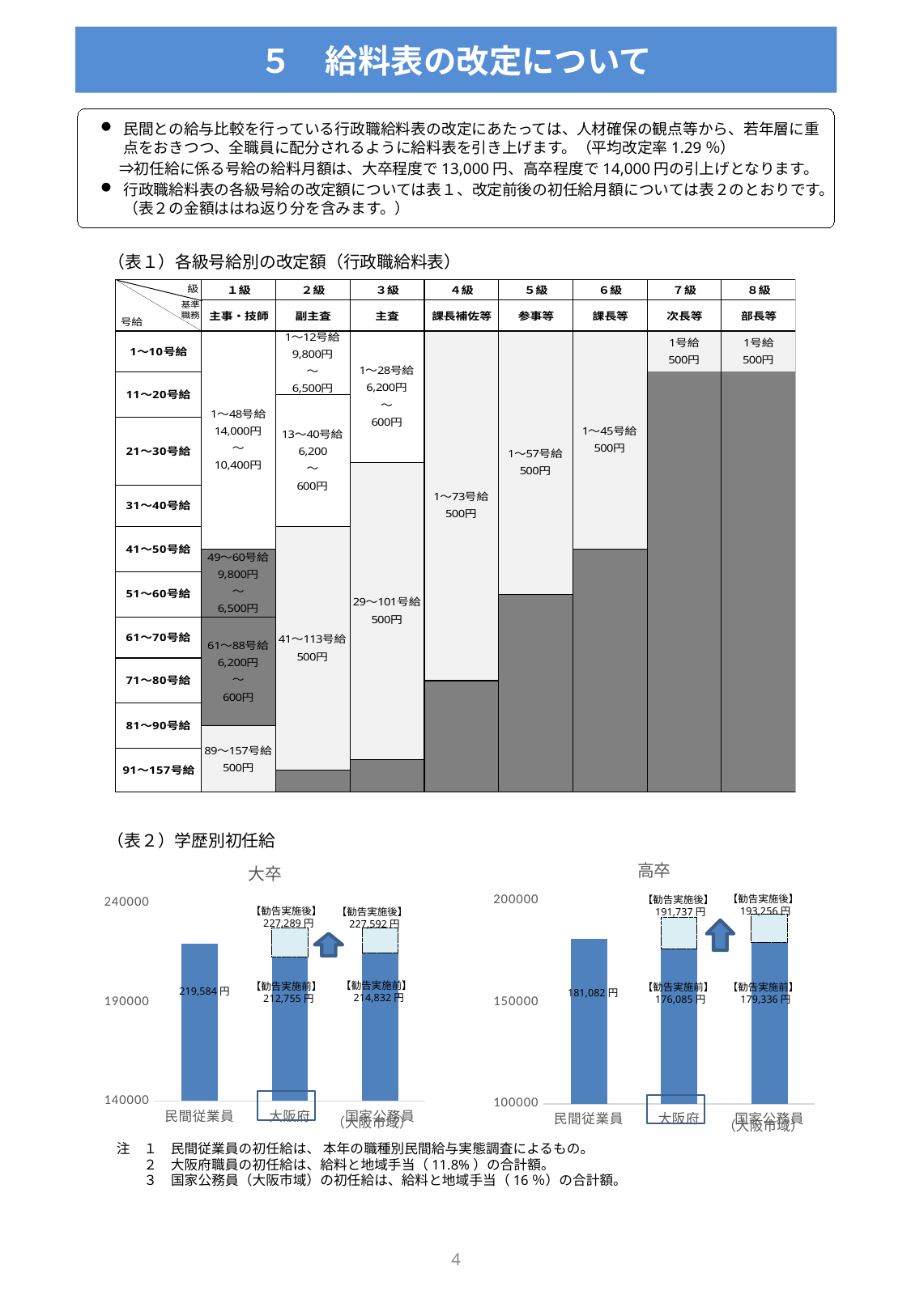
In the 大卒 chart, what is the difference between the 【勧告実施後】 and 【勧告実施前】 values for 大阪府? 14,534円 In the 大卒 chart, what is the 【勧告実施後】 value for 大阪府? 227,289円 In the 高卒 chart, what is the 【勧告実施前】 value for 大阪府? 176,085円 What kind of chart is the 大卒 chart? bar chart How many categories are shown on the x axis of the 高卒 chart? 3 In the 大卒 chart, what is the value shown for 民間従業員? 219,584円 In the 高卒 chart, what is the difference between the 【勧告実施後】 and 【勧告実施前】 values for 大阪府? 15,652円 In the 大卒 chart, what is the 【勧告実施前】 value for 国家公務員(大阪市域)? 214,832円 In the 高卒 chart, what is the value shown for 民間従業員? 181,082円 In the 高卒 chart, is the value for 民間従業員 greater or less than 150000? greater In the 大卒 chart, which is larger: the 【勧告実施前】 value for 大阪府 or the value for 民間従業員? 民間従業員 In the 高卒 chart, what is the 【勧告実施後】 value for 国家公務員(大阪市域)? 193,256円